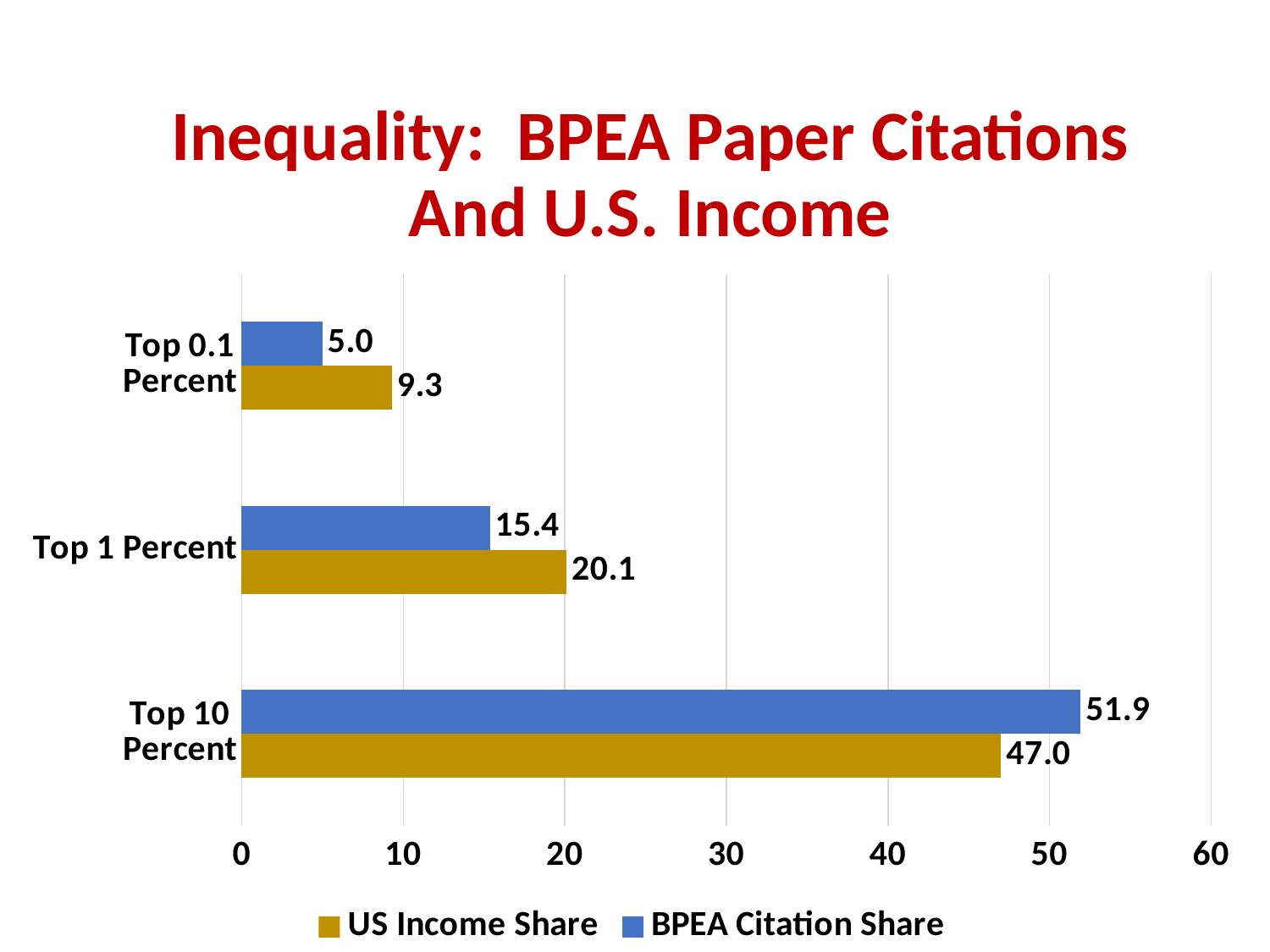
What is the US Income Share for the Top 0.1 Percent? 9.3 What is the BPEA Citation Share for the Top 10 Percent? 51.9 What kind of chart is shown on the slide? Bar chart What is the US Income Share for the Top 1 Percent? 20.1 What is the BPEA Citation Share for the Top 0.1 Percent? 5.0 For the Top 1 Percent, which is larger: the US Income Share or the BPEA Citation Share? US Income Share Which category has the lowest US Income Share? Top 0.1 Percent What is the difference between the US Income Share and the BPEA Citation Share for the Top 1 Percent? 4.7 How many series does the legend list? 2 How many categories are shown on the chart? 3 Which category has the highest BPEA Citation Share? Top 10 Percent What is the difference between the BPEA Citation Share and the US Income Share for the Top 10 Percent? 4.9